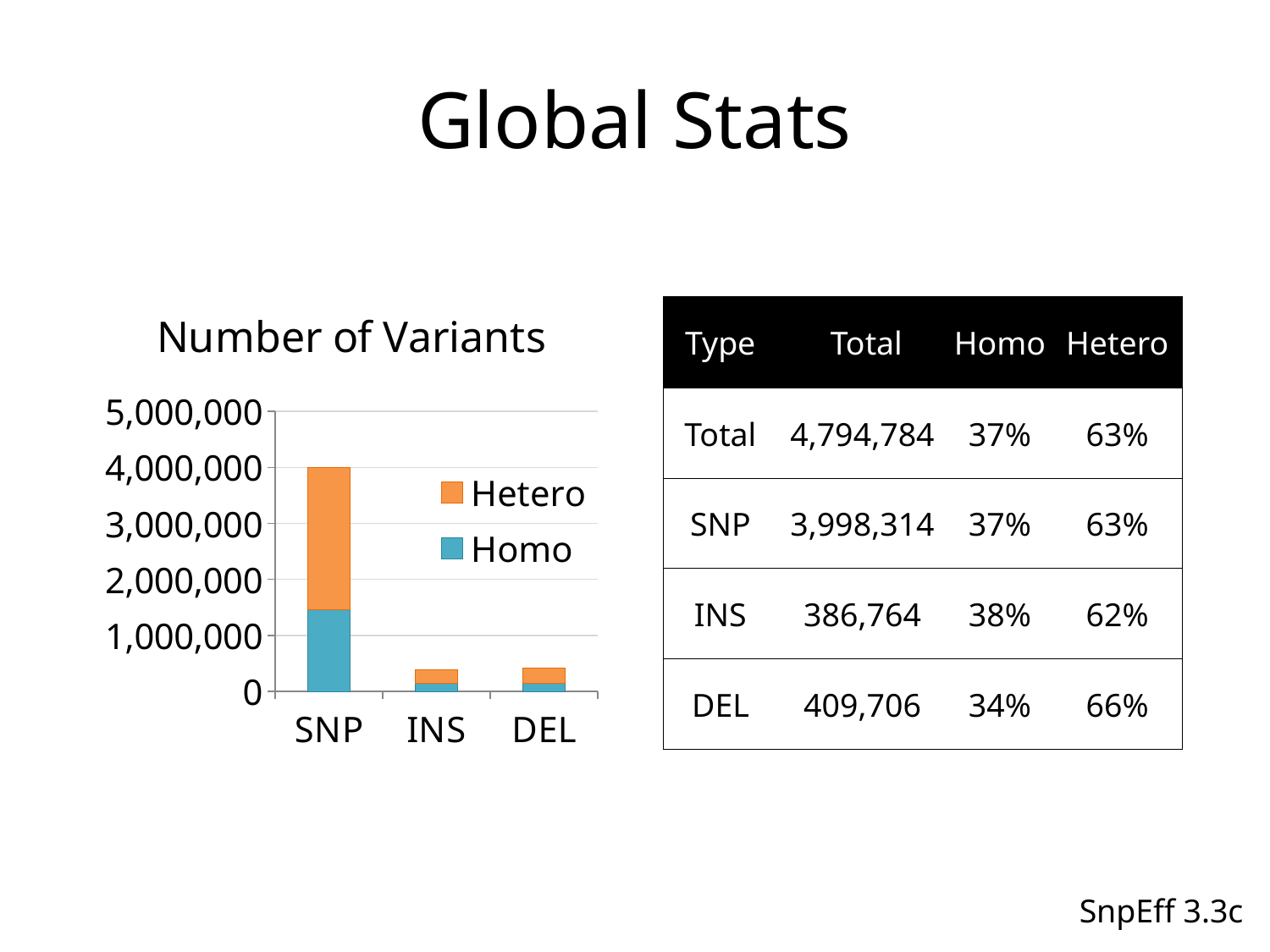
In the "Number of Variants" chart, is the total stacked bar for DEL greater or less than 1,000,000? less What kind of chart is shown under the title "Number of Variants"? stacked bar chart What is the title of the chart on the slide? Number of Variants In the "Number of Variants" chart, is the Homo segment of the SNP bar greater or less than 1,000,000? greater How many categories are shown on the x axis of the "Number of Variants" chart? 3 In the "Number of Variants" chart, is the total stacked bar for INS greater or less than 1,000,000? less In the "Number of Variants" chart, which is larger for SNP: the Hetero segment or the Homo segment? Hetero Which series are listed in the legend of the "Number of Variants" chart? Hetero and Homo How many series does the legend of the "Number of Variants" chart list? 2 Which category has the tallest stacked bar in the "Number of Variants" chart? SNP In the "Number of Variants" chart, which stacked bar is taller: SNP or INS? SNP